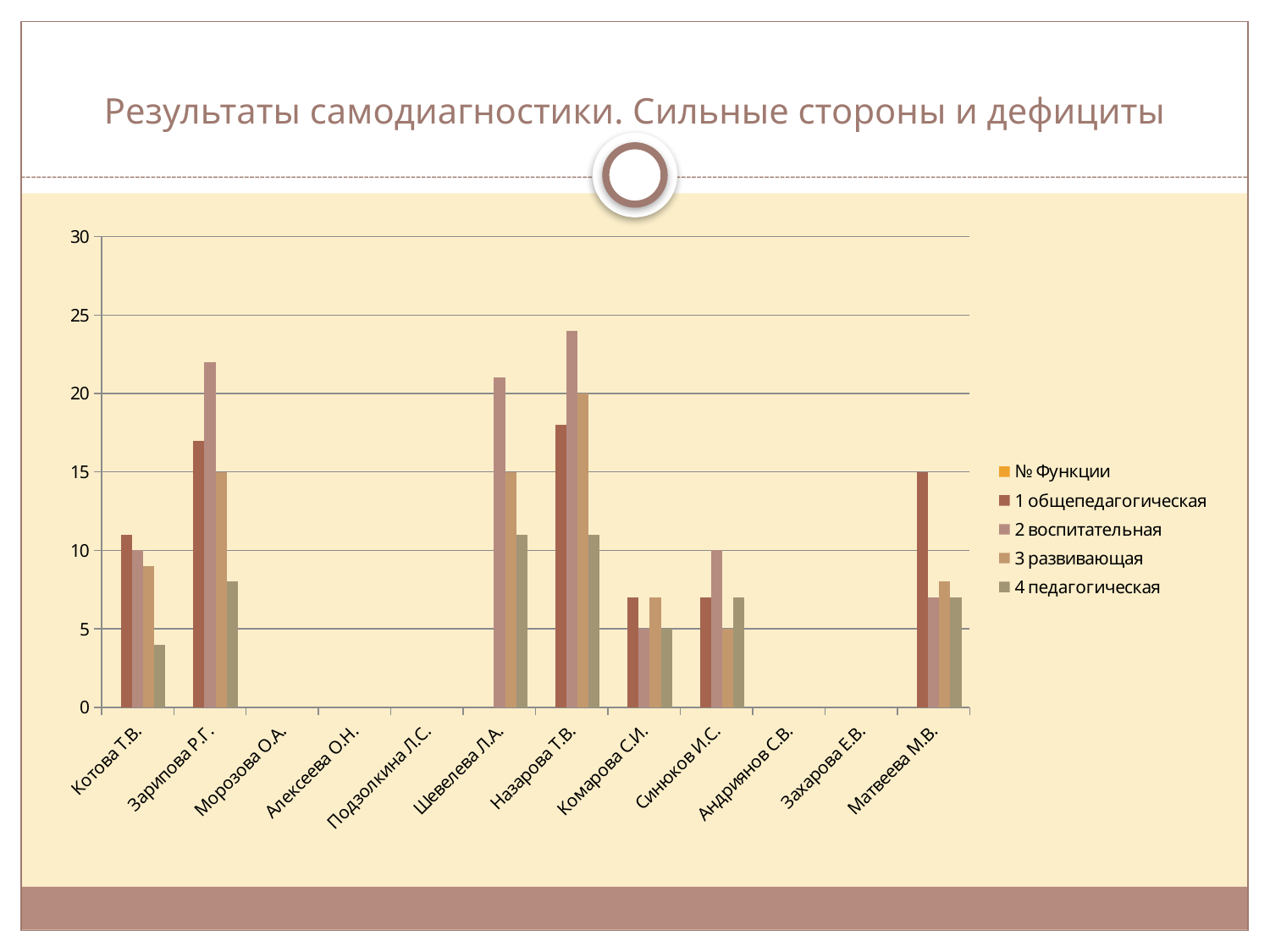
Which is larger: the 2 воспитательная value for Синюков И.С. or for Комарова С.И.? Синюков И.С. Which is larger: the 1 общепедагогическая value for Зарипова Р.Г. or for Котова Т.В.? Зарипова Р.Г. Is the value of 4 педагогическая for Котова Т.В. greater or less than 5? less How many categories (names) are listed along the x axis? 12 Is the value of 2 воспитательная for Шевелева Л.А. greater or less than 20? greater How many series does the legend list? 5 What kind of chart is shown on the slide? bar chart Is the value of 2 воспитательная for Назарова Т.В. greater or less than 20? greater How many categories on the x axis have no bars plotted at all? 5 What is the title of the slide containing the chart? Результаты самодиагностики. Сильные стороны и дефициты Which category has the tallest bar in the chart? Назарова Т.В.